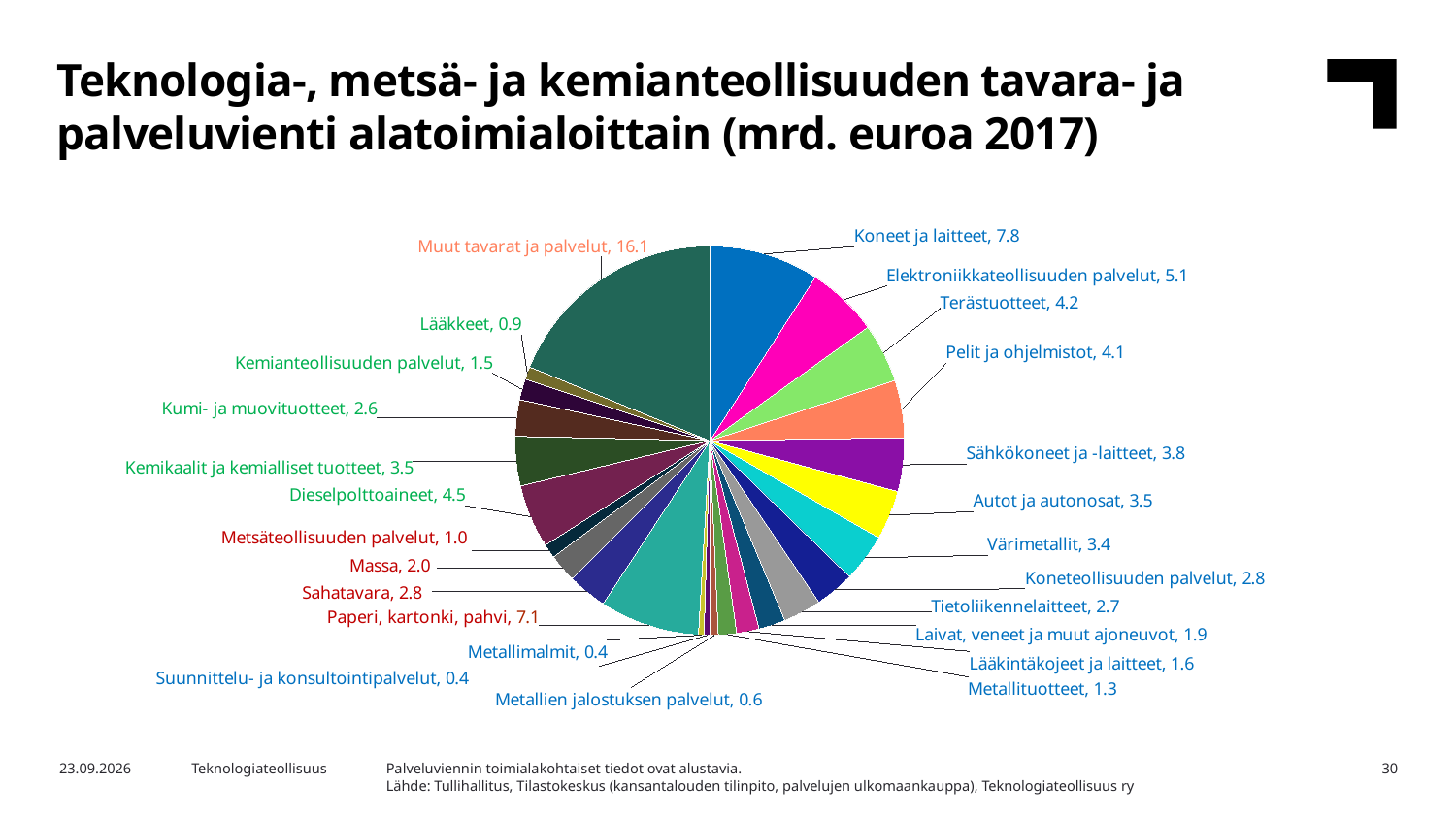
What is the value for Lääkintäkojeet ja laitteet? 1.6 What is the difference between Koneet ja laitteet and Paperi, kartonki, pahvi? 0.7 Which is larger, Sahatavara or Massa? Sahatavara What kind of chart is shown on the slide? Pie chart Which category has the largest slice in the pie chart? Muut tavarat ja palvelut Which is larger, Elektroniikkateollisuuden palvelut or Sähkökoneet ja -laitteet? Elektroniikkateollisuuden palvelut What is the difference between Muut tavarat ja palvelut and Koneet ja laitteet? 8.3 What is the value for Kemianteollisuuden palvelut? 1.5 What is the value for Paperi, kartonki, pahvi? 7.1 How many slices does the pie chart have? 25 What is the value for Koneet ja laitteet? 7.8 What is the value for Dieselpolttoaineet? 4.5